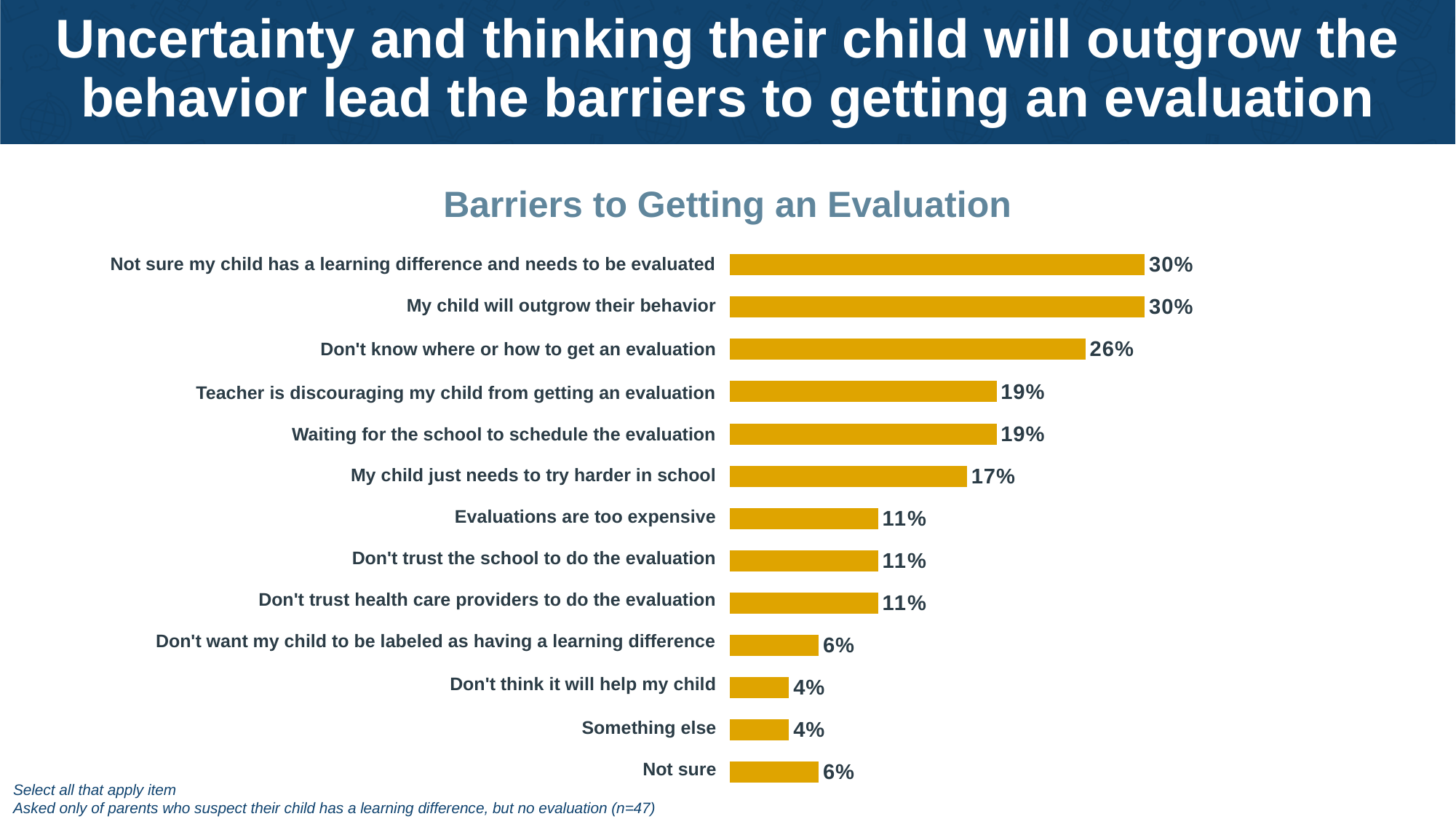
How many barrier categories are shown in the chart? 13 What is the title of the chart? Barriers to Getting an Evaluation What is the value for "My child just needs to try harder in school"? 17% Which is larger, "Waiting for the school to schedule the evaluation" or "Don't trust health care providers to do the evaluation"? Waiting for the school to schedule the evaluation What percentage of parents said "Don't know where or how to get an evaluation" was a barrier? 26% What type of chart is used to show the barriers to getting an evaluation? Bar chart Which barrier has the lowest value, "Don't think it will help my child" or "Not sure"? Don't think it will help my child What is the difference between "My child will outgrow their behavior" and "Teacher is discouraging my child from getting an evaluation"? 11 percentage points What is the sample size (n) noted for this chart? n=47 What is the value for "Don't want my child to be labeled as having a learning difference"? 6% What is the value for "Evaluations are too expensive"? 11% What is the difference between "Don't know where or how to get an evaluation" and "Don't trust the school to do the evaluation"? 15 percentage points